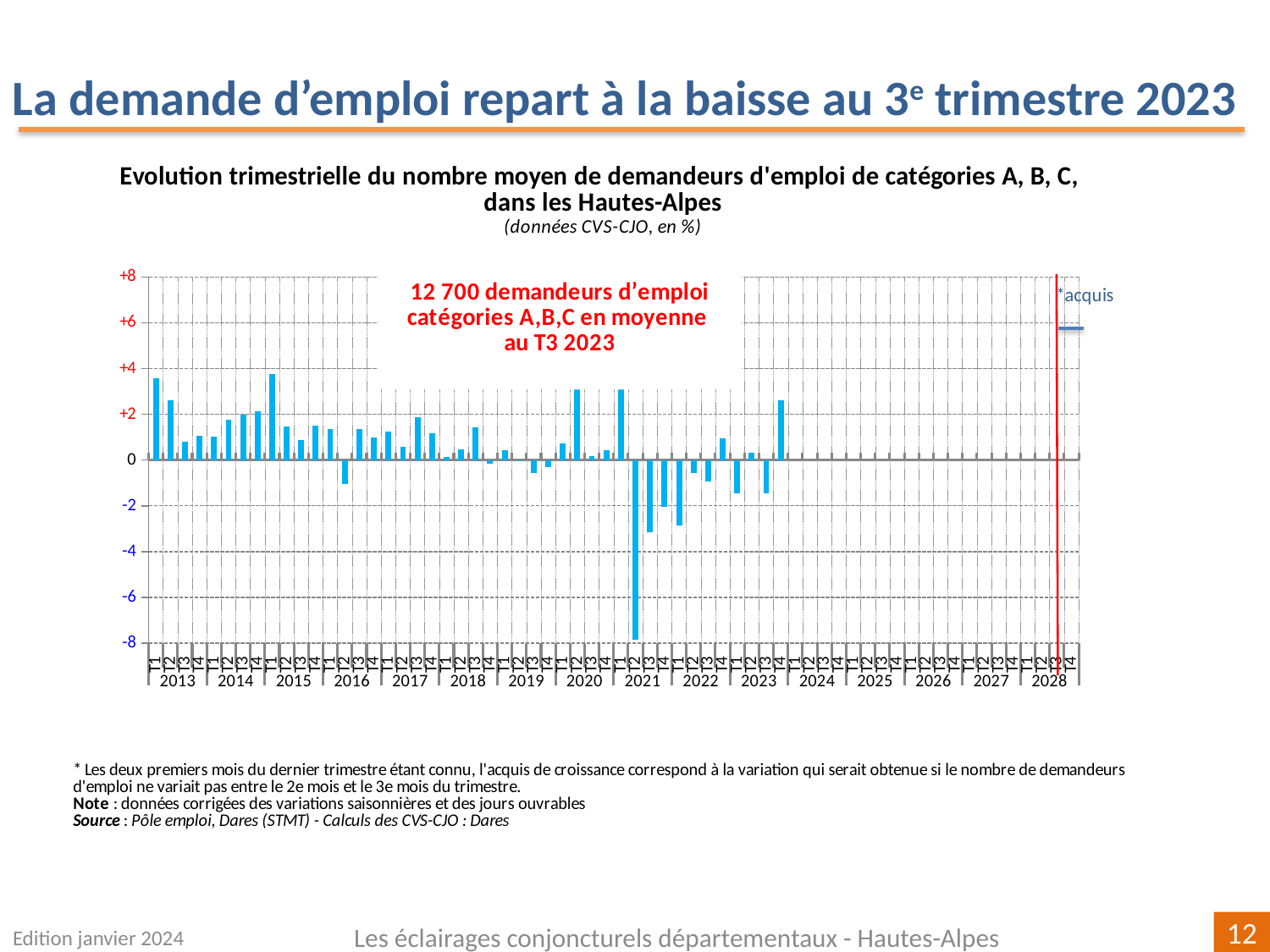
In which year does the lowest bar on the chart occur? 2021 According to the text on the chart, how many demandeurs d'emploi of categories A, B, C were there on average in T3 2023? 12 700 What is the lowest value shown on the vertical axis? -8 Is the value of the highest bar on the chart greater or less than +2? greater In what unit are the chart's values expressed, according to the subtitle? en % Is the value of the lowest bar on the chart greater or less than -6? less What kind of chart is shown on the slide? bar chart